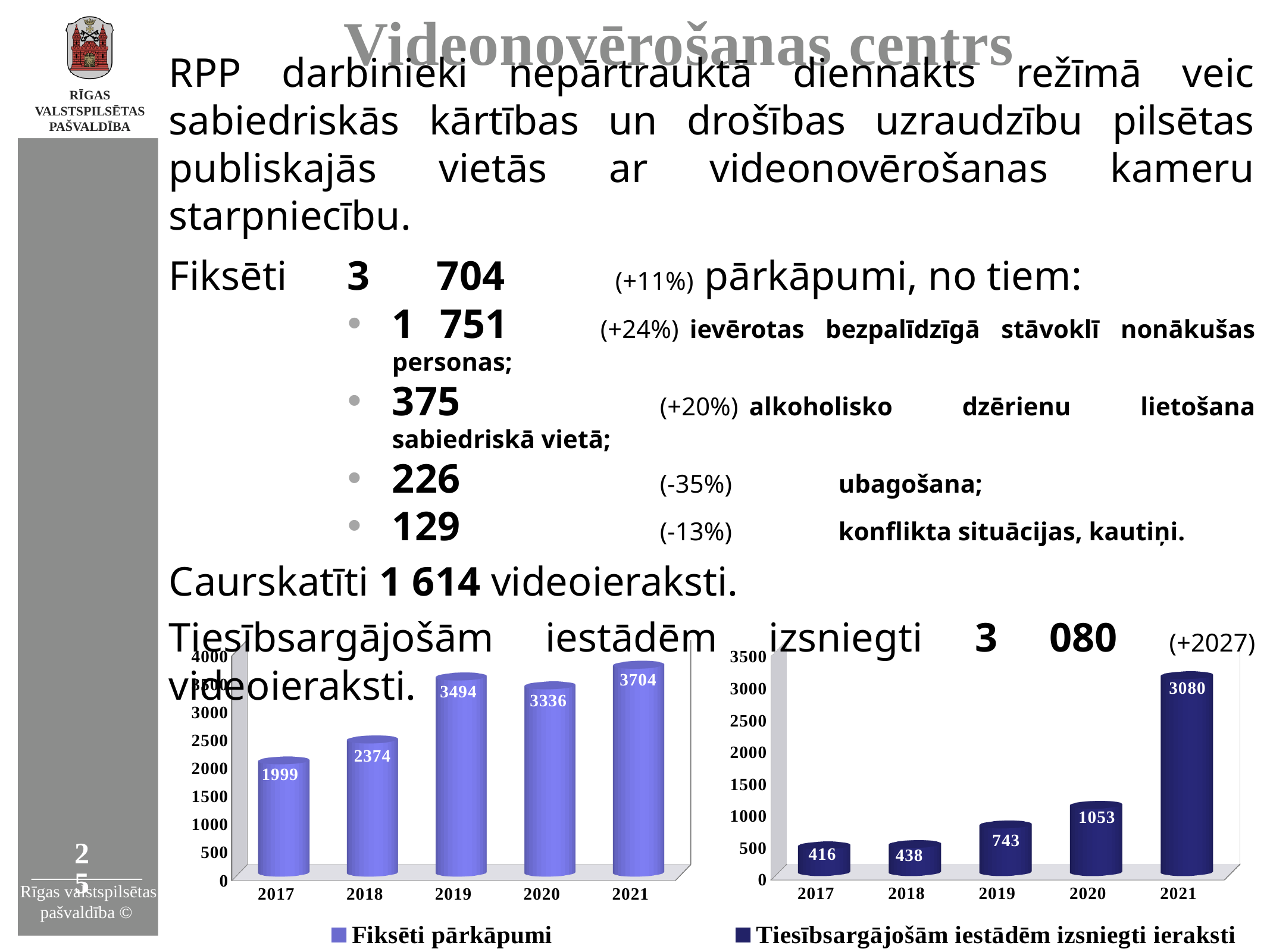
In the left chart (Fiksēti pārkāpumi), which year has the lowest value? 2017 In the right chart (Tiesībsargājošām iestādēm izsniegti ieraksti), what is the difference between the values for 2021 and 2020? 2027 How many years are shown on the x axis of the left chart (Fiksēti pārkāpumi)? 5 In the left chart (Fiksēti pārkāpumi), which is larger, the value for 2019 or the value for 2020? 2019 In the right chart (Tiesībsargājošām iestādēm izsniegti ieraksti), what is the value for 2020? 1053 In the left chart (Fiksēti pārkāpumi), what is the value for 2019? 3494 In the right chart (Tiesībsargājošām iestādēm izsniegti ieraksti), which year has the highest value? 2021 In the left chart (Fiksēti pārkāpumi), which year has the highest value? 2021 What kind of chart is the right chart (Tiesībsargājošām iestādēm izsniegti ieraksti)? bar chart In the right chart (Tiesībsargājošām iestādēm izsniegti ieraksti), is the value for 2019 greater or less than 1000? less In the left chart (Fiksēti pārkāpumi), what is the difference between the values for 2021 and 2020? 368 What is the legend entry of the left chart? Fiksēti pārkāpumi